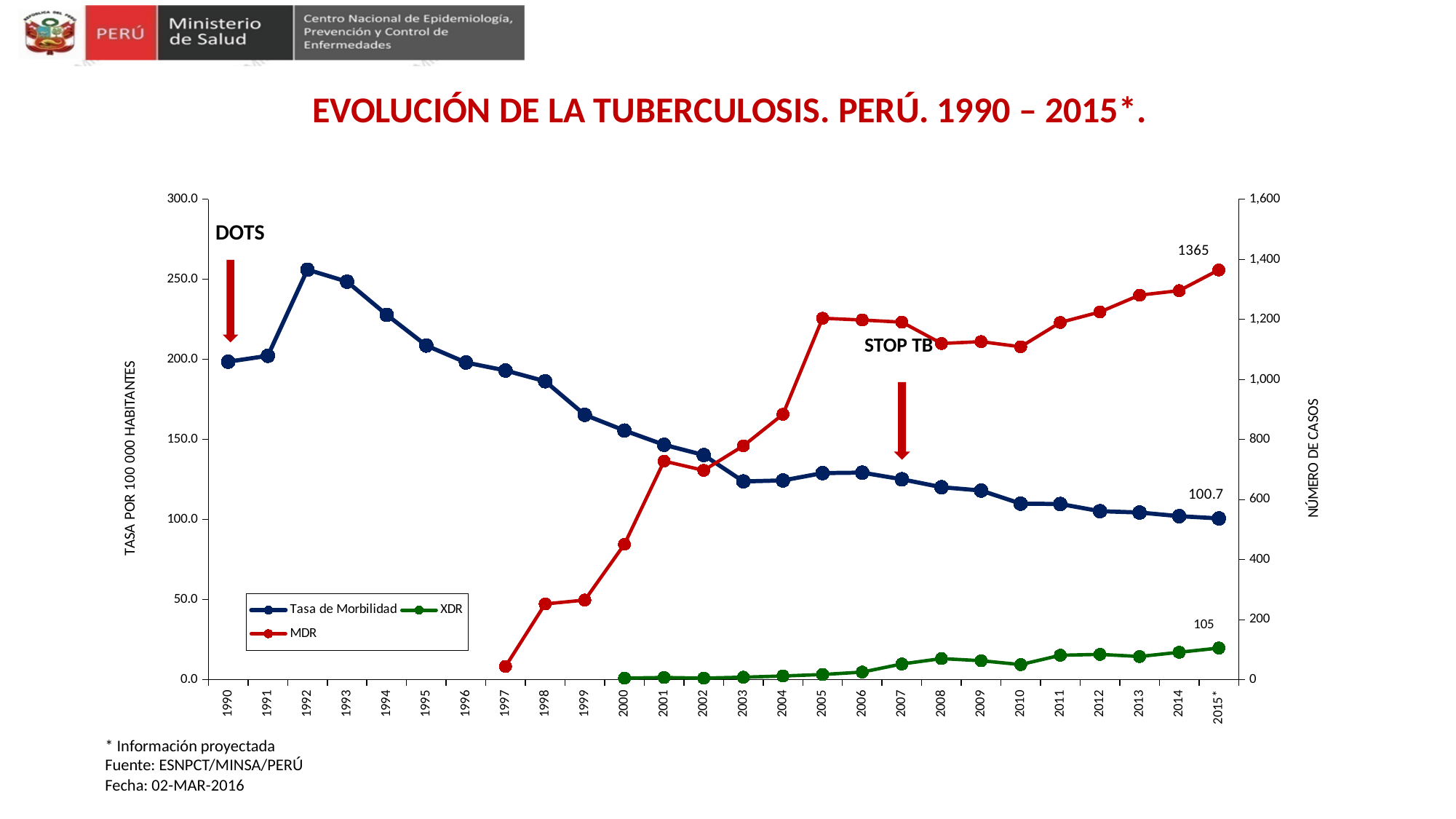
What is the XDR value for 2015*? 105 What kind of chart is shown on the slide? line chart Is the MDR value for 2005 greater or less than 1,000? greater In which year is the Tasa de Morbilidad highest? 1992 What is the MDR value for 2015*? 1365 How many series does the legend list? 3 What is the difference between the MDR and XDR values in 2015*? 1260 Does the Tasa de Morbilidad rise or fall from 1992 to 2015*? fall Is the Tasa de Morbilidad value for 1994 greater or less than 200.0? greater What is the Tasa de Morbilidad value for 2015*? 100.7 In 2015*, which is larger, MDR or XDR? MDR What is the label of the right-hand vertical axis? NÚMERO DE CASOS